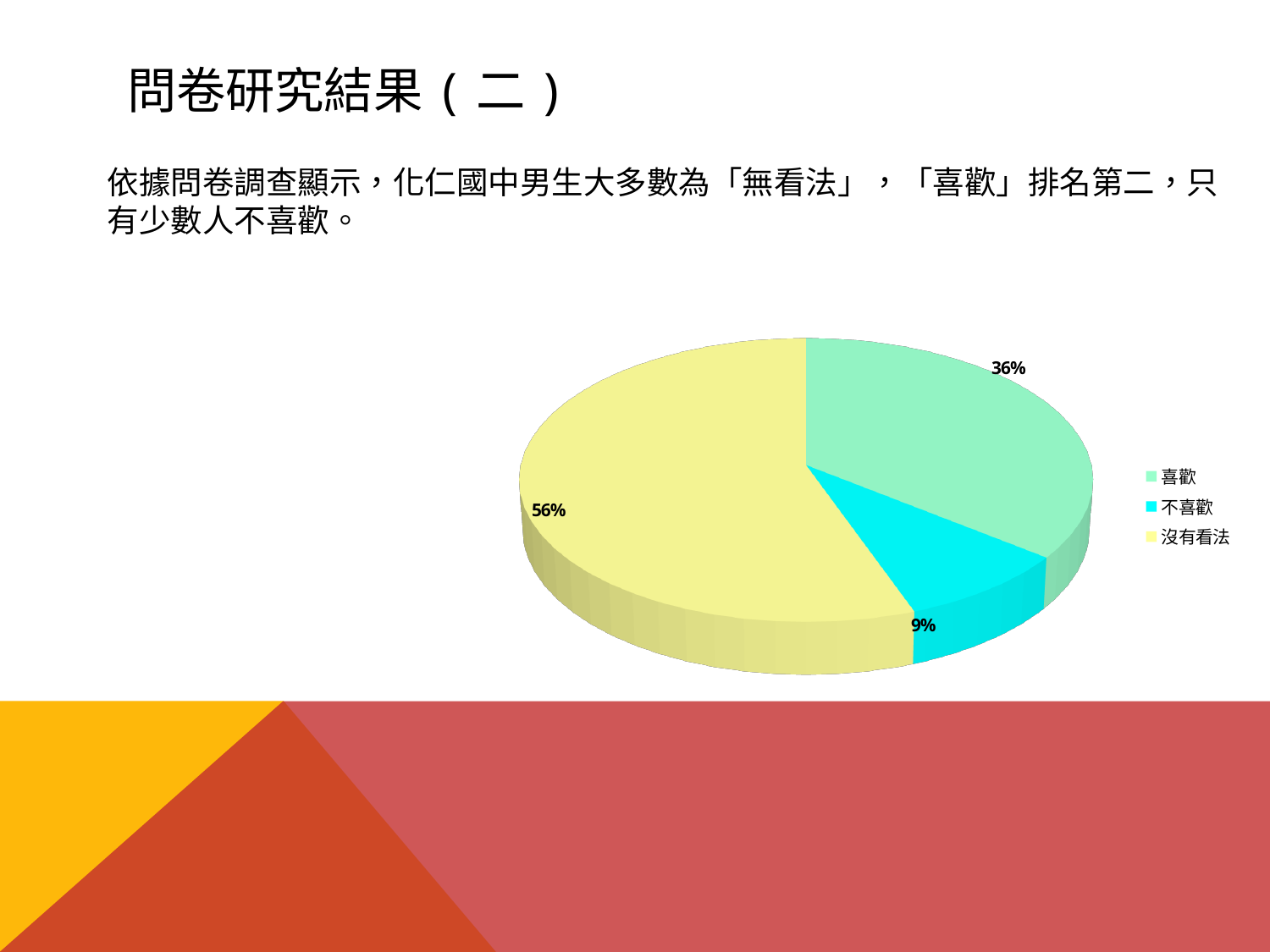
What share of the pie does 喜歡 represent? 36% Which category has the smallest slice of the pie? 不喜歡 How many categories does the pie chart have? 3 What share of the pie does 不喜歡 represent? 9% What is the difference in percentage points between 喜歡 and 不喜歡? 27% How many entries does the legend list? 3 What colour is the slice for 不喜歡? cyan What share of the pie does 沒有看法 represent? 56% Which category has the largest slice of the pie? 沒有看法 Which is larger, the slice for 喜歡 or the slice for 不喜歡? 喜歡 What is the difference in percentage points between 沒有看法 and 喜歡? 20% What kind of chart is shown on the slide? pie chart